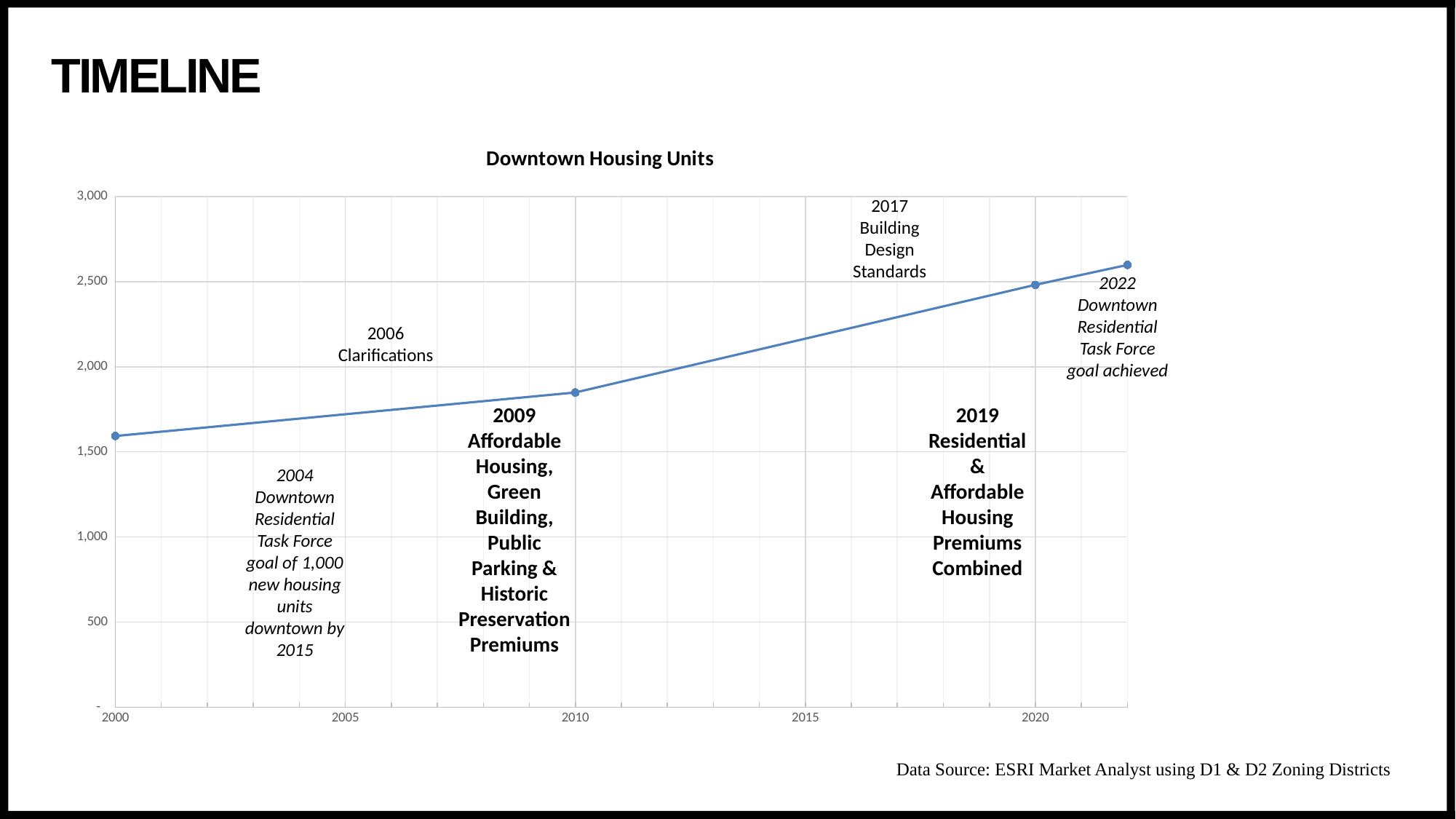
Is the value for 2022 greater or less than 2,000? greater Is the value for 2020 greater or less than 2,000? greater How many data points are plotted on the line? 4 Is the value for 2000 greater or less than 1,500? greater According to the annotation on the chart, what event is marked in 2017? Building Design Standards What kind of chart is shown on the slide? line chart Which year has the highest number of downtown housing units? 2022 What is the title of the chart? Downtown Housing Units Which year has the lowest number of downtown housing units? 2000 Do downtown housing units rise or fall from 2000 to 2022? rise Which year has more downtown housing units, 2010 or 2020? 2020